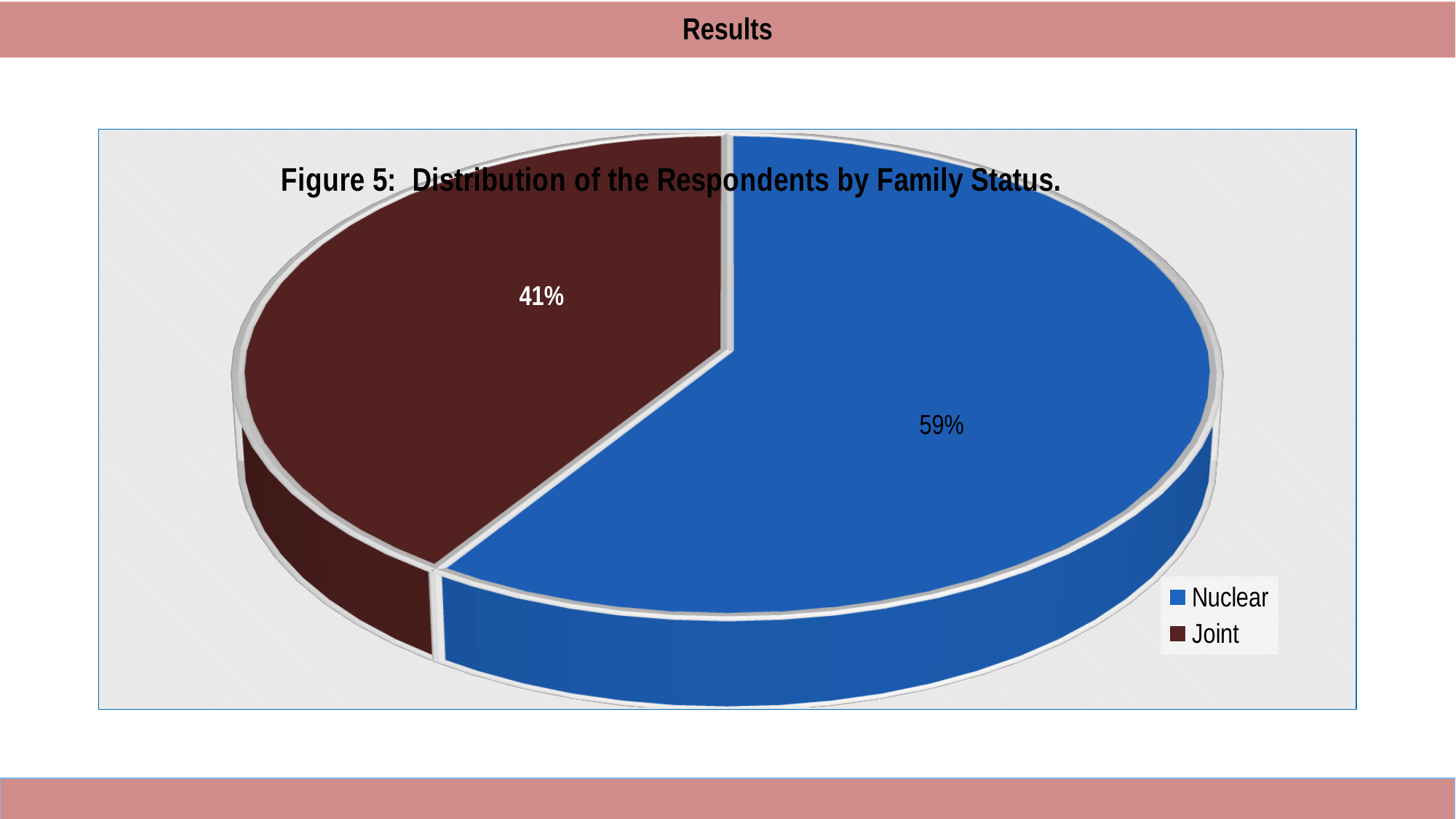
Which family status has the smallest share of respondents? Joint How many entries does the legend list? 2 What is the difference in percentage points between the Nuclear and Joint shares? 18 percentage points How many categories are shown in the pie chart? 2 Which is larger, the share for Nuclear or the share for Joint? Nuclear What colour is the Nuclear slice in the pie chart? Blue What kind of chart is shown on the slide? Pie chart What percentage of respondents have a Joint family status? 41% Which family status has the largest share of respondents? Nuclear What share of the pie does the Joint slice represent? 41% What is the title of the chart? Figure 5: Distribution of the Respondents by Family Status. What percentage of respondents have a Nuclear family status? 59%